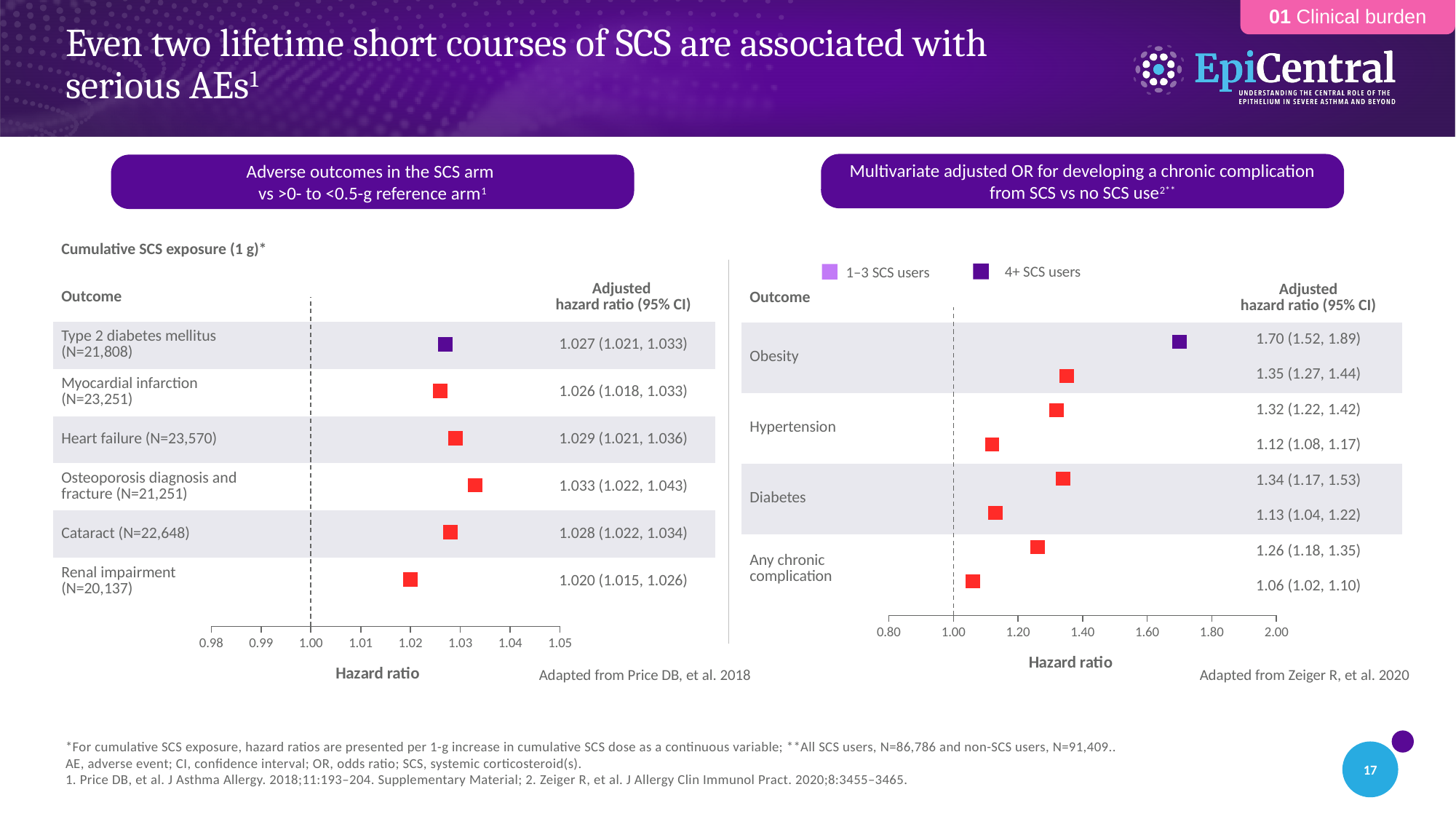
In the left chart (Adverse outcomes in the SCS arm), which outcome has the lowest adjusted hazard ratio? Renal impairment In the left chart (Adverse outcomes in the SCS arm), what adjusted hazard ratio (95% CI) is printed for Heart failure? 1.029 (1.021, 1.036) In the right chart (Multivariate adjusted OR for developing a chronic complication), is the highest hazard ratio for Obesity greater or less than 1.60? greater In the left chart (Adverse outcomes in the SCS arm), what adjusted hazard ratio (95% CI) is printed for Renal impairment? 1.020 (1.015, 1.026) In the left chart (Adverse outcomes in the SCS arm), which outcome has the highest adjusted hazard ratio? Osteoporosis diagnosis and fracture In the right chart (Multivariate adjusted OR for developing a chronic complication), how many outcomes are listed? 4 In the left chart (Adverse outcomes in the SCS arm), which has the larger adjusted hazard ratio: Cataract or Myocardial infarction? Cataract In the right chart (Multivariate adjusted OR for developing a chronic complication), how many series does the legend list? 2 In the right chart (Multivariate adjusted OR for developing a chronic complication), what is the lowest adjusted hazard ratio printed? 1.06 (1.02, 1.10) In the left chart (Adverse outcomes in the SCS arm), how many outcomes are plotted? 6 In the left chart (Adverse outcomes in the SCS arm), what is the difference between the adjusted hazard ratios for Osteoporosis diagnosis and fracture and Renal impairment? 0.013 In the right chart (Multivariate adjusted OR for developing a chronic complication), which outcome has the highest adjusted hazard ratio? Obesity